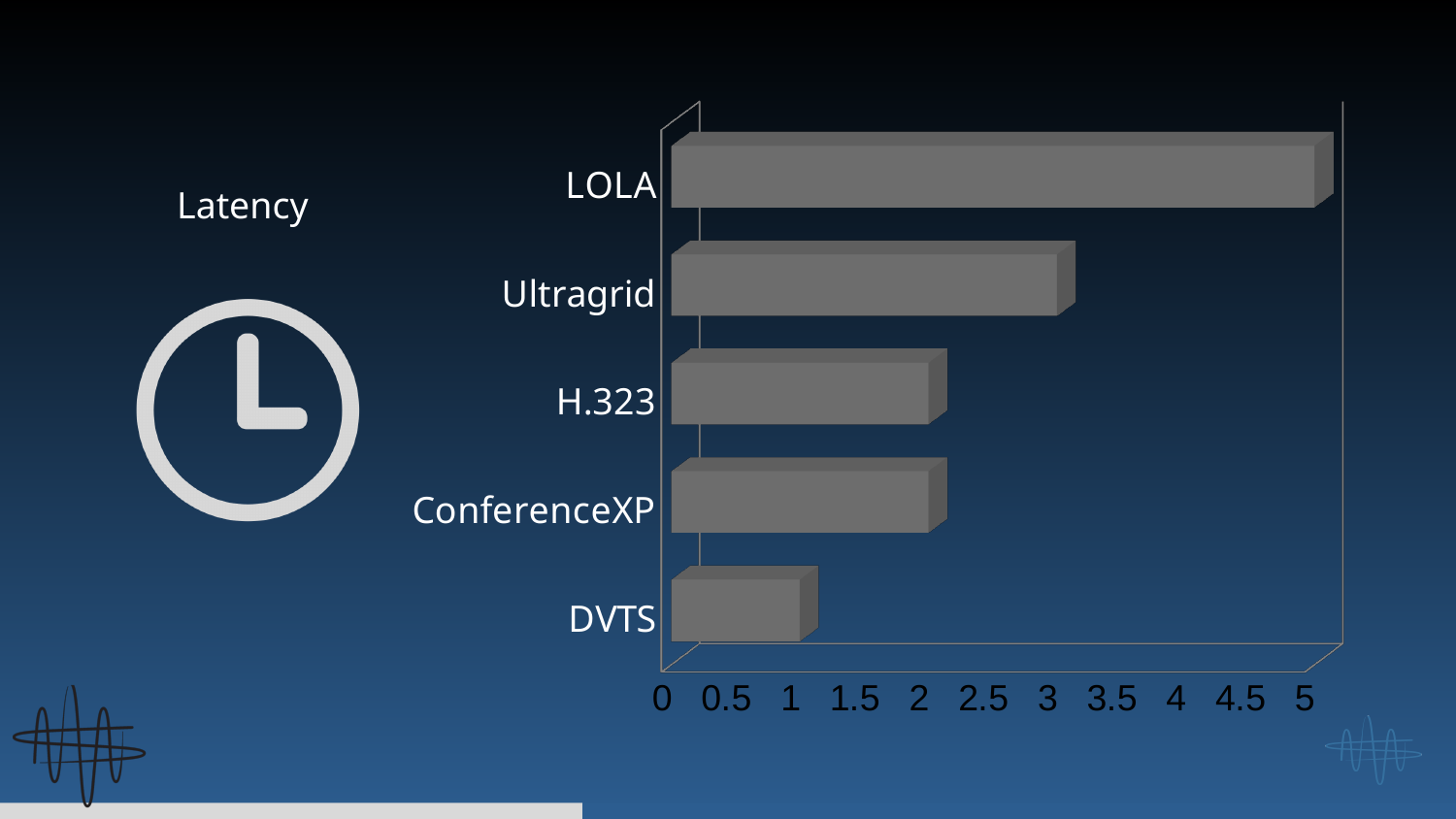
Is the value for Ultragrid greater or less than 2.5? greater Is the value for ConferenceXP greater or less than 1.5? greater Which has the larger value, LOLA or Ultragrid? LOLA What is the highest tick value shown on the horizontal axis of the chart? 5 Which category has the lowest value in the chart? DVTS Which has the larger value, DVTS or Ultragrid? Ultragrid Is the value for H.323 greater or less than 2.5? less Which category has the highest value in the chart? LOLA How many categories are plotted in the chart? 5 What kind of chart is shown on the slide? bar chart